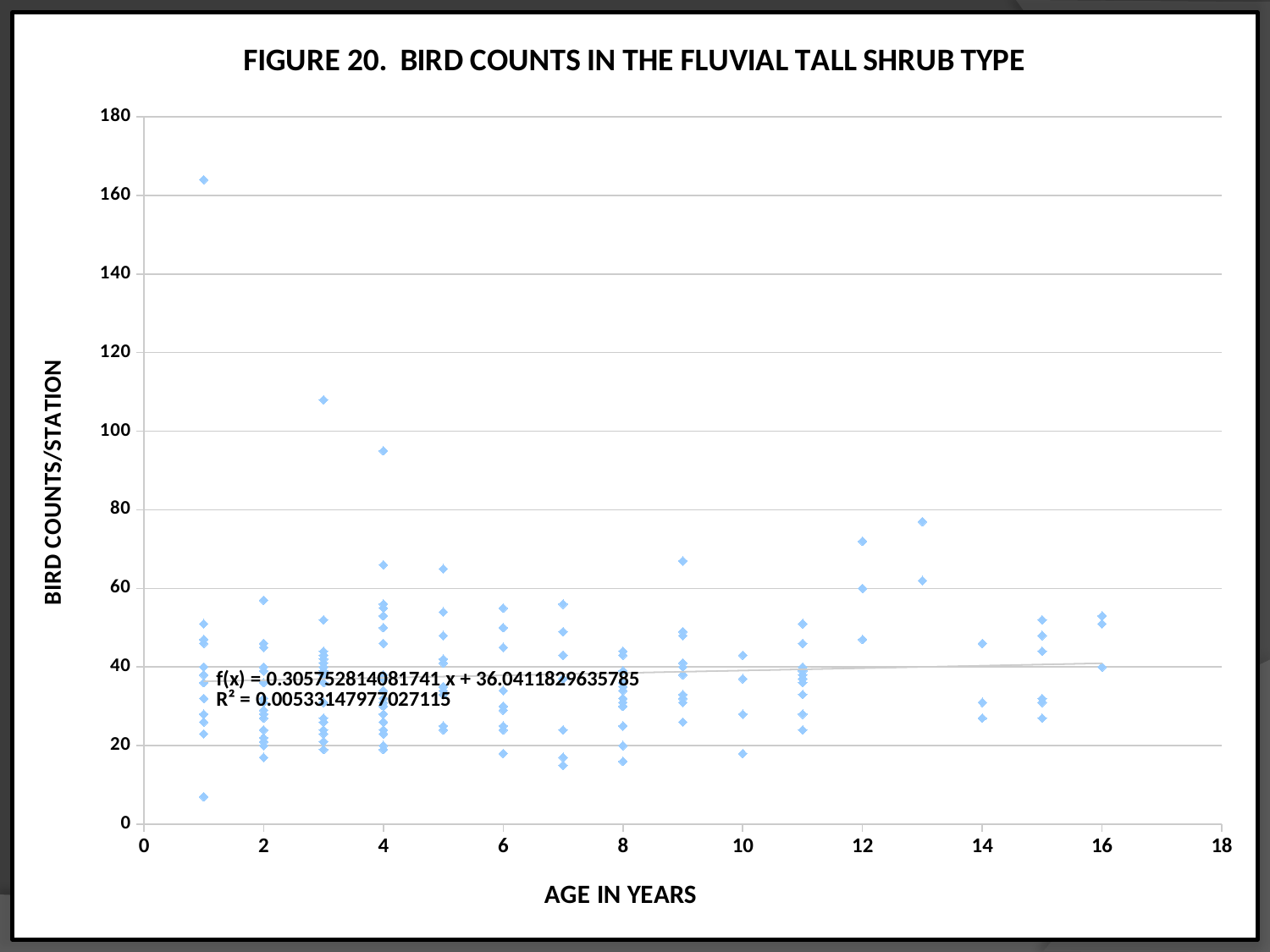
Is the highest bird count at age 3 greater or less than 100? greater Does the fitted trendline rise or fall as age in years increases? Rise Which is larger: the highest bird count at age 3 or the highest bird count at age 4? Age 3 Is the highest bird count at age 1 greater or less than 140? greater Is the lowest bird count at age 1 greater or less than 20? less What R² value is printed on the chart? 0.00533147977027115 What kind of chart is shown on the slide? Scatter chart What is the label of the x axis? AGE IN YEARS At which age in years does the highest bird count per station occur? 1 What is the title of the chart? FIGURE 20. BIRD COUNTS IN THE FLUVIAL TALL SHRUB TYPE